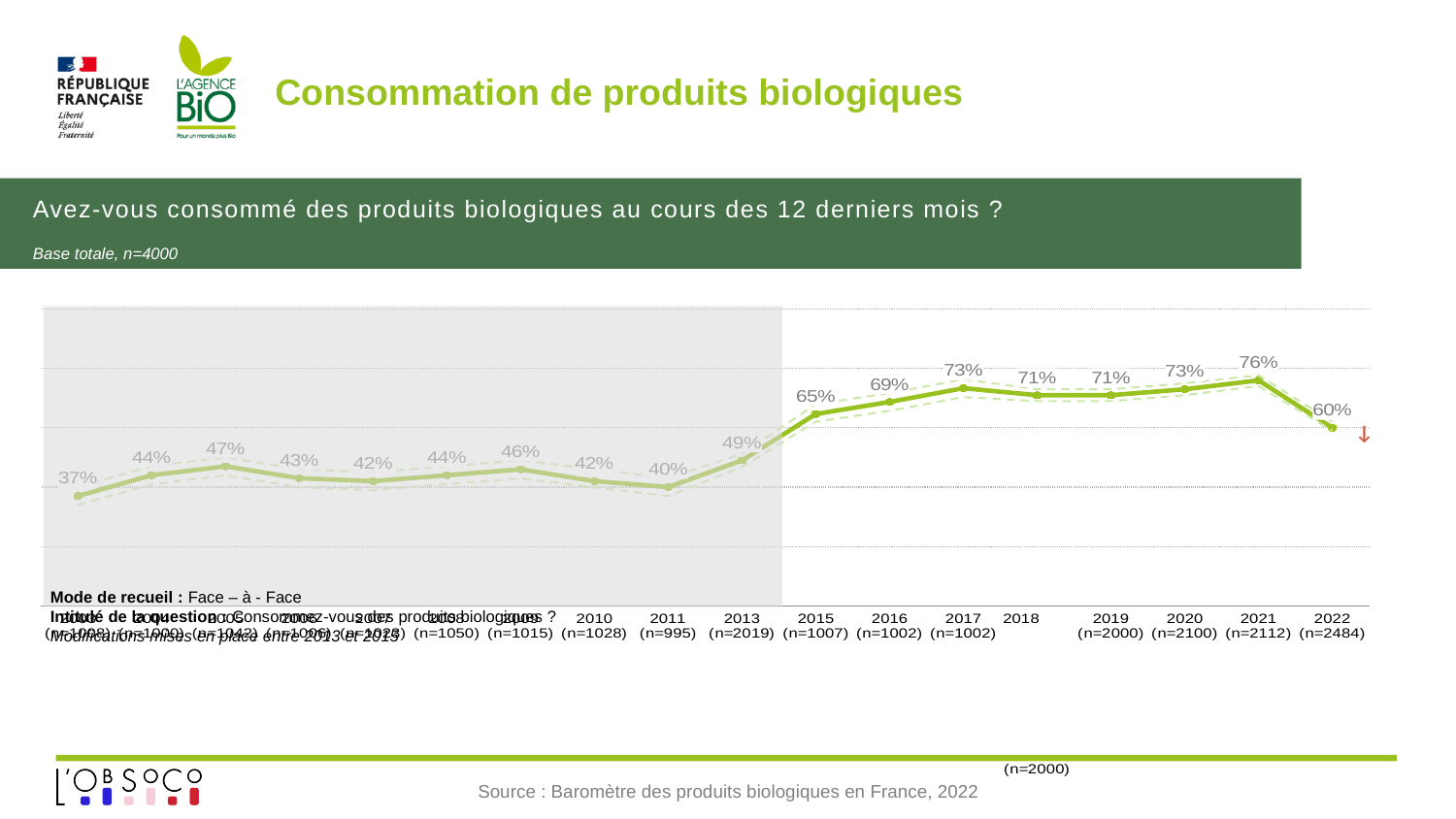
What is the value for 2017? 73% What is the lowest value shown on the chart? 37% What is the value for 2016? 69% How many data points are plotted on the line? 18 What kind of chart is shown on the slide? line chart Which is larger, the value for 2016 or the value for 2020? 2020 What is the value for 2021? 76% What is the value for 2022? 60% What is the difference between the values for 2021 and 2022? 16 percentage points Does the value rise or fall from 2021 to 2022? fall What is the value for 2015? 65% Which year has the highest value on the chart? 2021